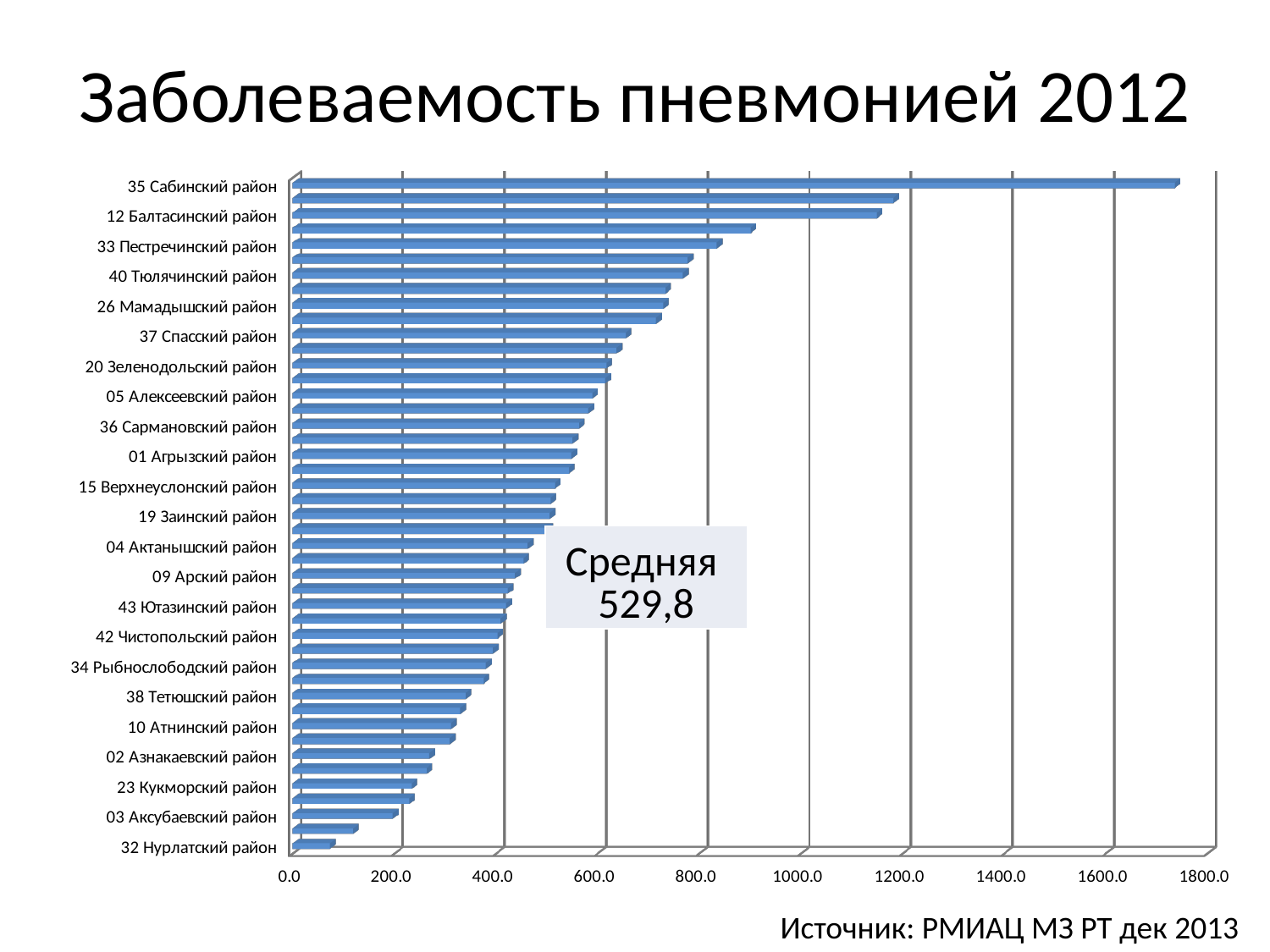
What kind of chart is shown on the slide? bar chart Which district has the lowest pneumonia incidence in the chart? 32 Нурлатский район Is the value for 15 Верхнеуслонский район greater or less than 600? less Is the value for 26 Мамадышский район greater or less than 600? greater Is the value for 38 Тетюшский район greater or less than 400? less Which has the larger value: 12 Балтасинский район or 33 Пестречинский район? 12 Балтасинский район Which district has the highest pneumonia incidence in the chart? 35 Сабинский район What average value (Средняя) is shown in the box on the chart? 529,8 Do the bar values rise or fall going from the top of the chart to the bottom? fall